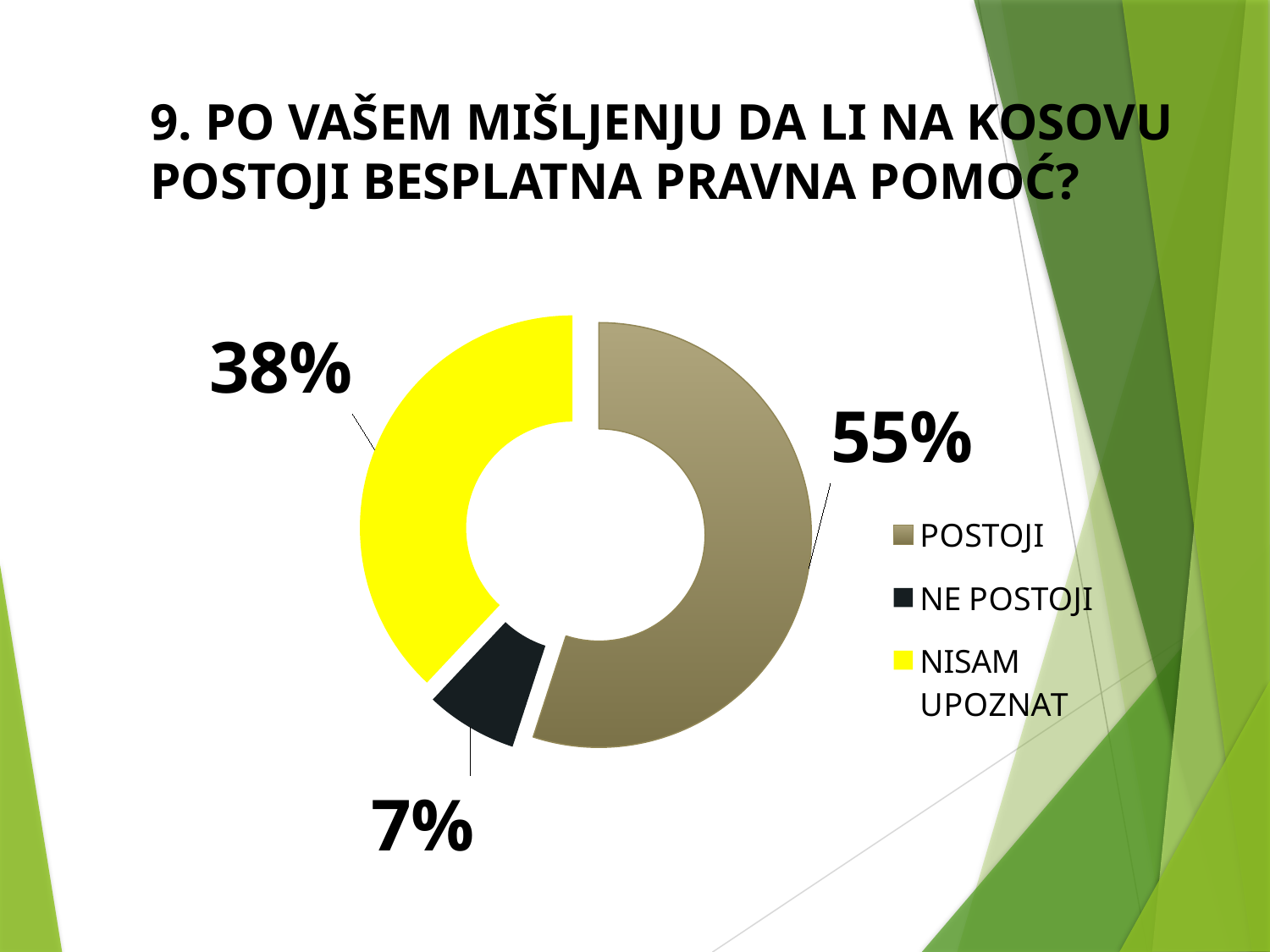
What colour represents NISAM UPOZNAT in the chart? Yellow What is the difference in percentage points between POSTOJI and NISAM UPOZNAT? 17 What kind of chart is shown on the slide? Doughnut chart What is the difference in percentage points between NISAM UPOZNAT and NE POSTOJI? 31 Which category has the smallest share of the chart? NE POSTOJI What percentage of respondents answered NE POSTOJI? 7% Which is larger, the share for POSTOJI or the share for NISAM UPOZNAT? POSTOJI What percentage of respondents answered POSTOJI? 55% How many categories does the chart show? 3 What percentage of respondents answered NISAM UPOZNAT? 38% Which category has the largest share of the chart? POSTOJI What is the combined share of POSTOJI and NE POSTOJI? 62%